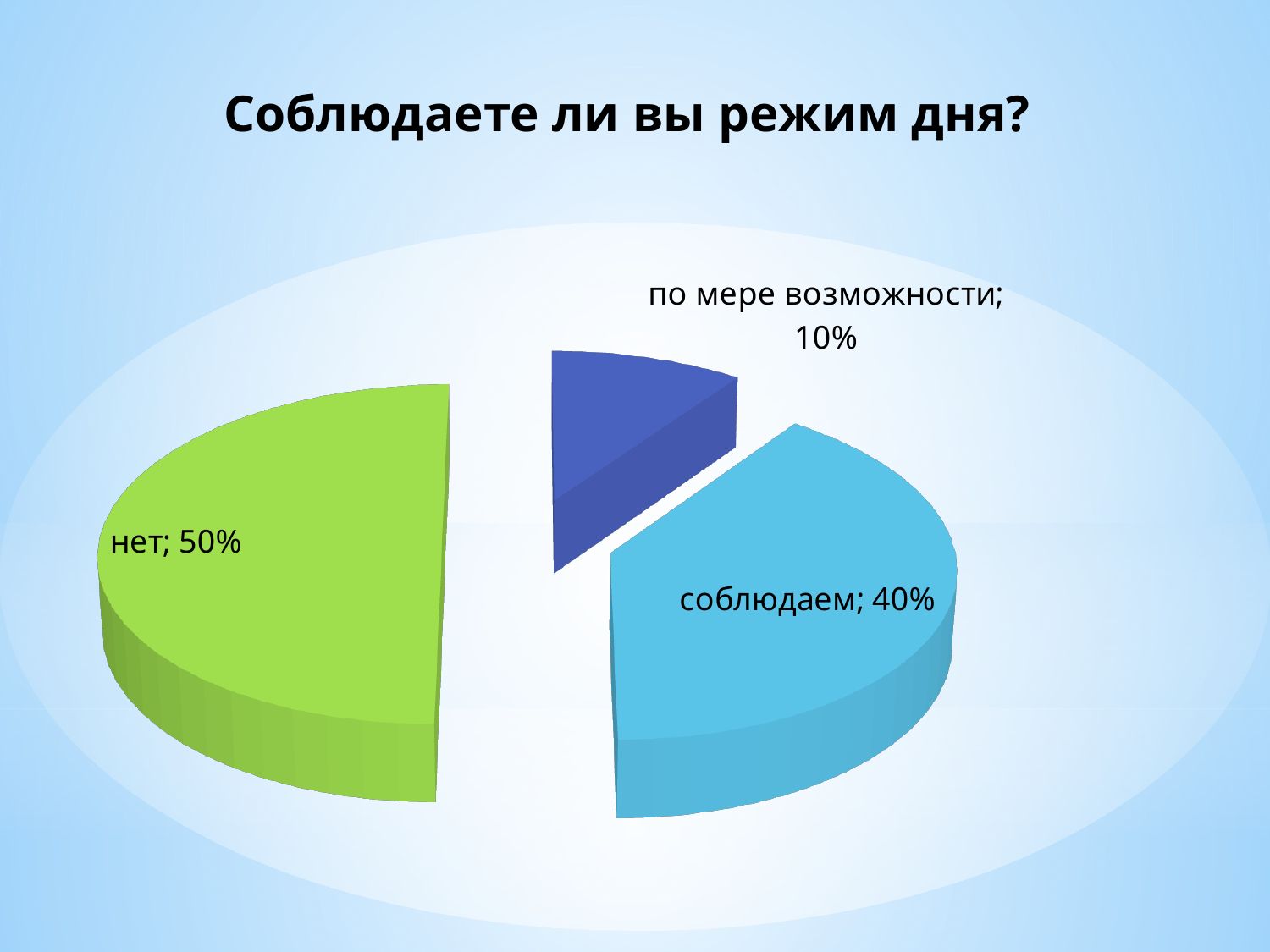
What colour is the slice for "нет"? green How many slices does the pie chart have? 3 Which category has the largest share of the pie? нет What is the title of the chart? Соблюдаете ли вы режим дня? What is the value for "соблюдаем"? 40% What is the value for "по мере возможности"? 10% What type of chart is shown on the slide? pie chart What is the difference between the values for "соблюдаем" and "по мере возможности"? 30% Which category has the smallest share of the pie? по мере возможности What is the value for "нет"? 50% What is the difference between the values for "нет" and "соблюдаем"? 10% Which is larger, the value for "соблюдаем" or the value for "по мере возможности"? соблюдаем